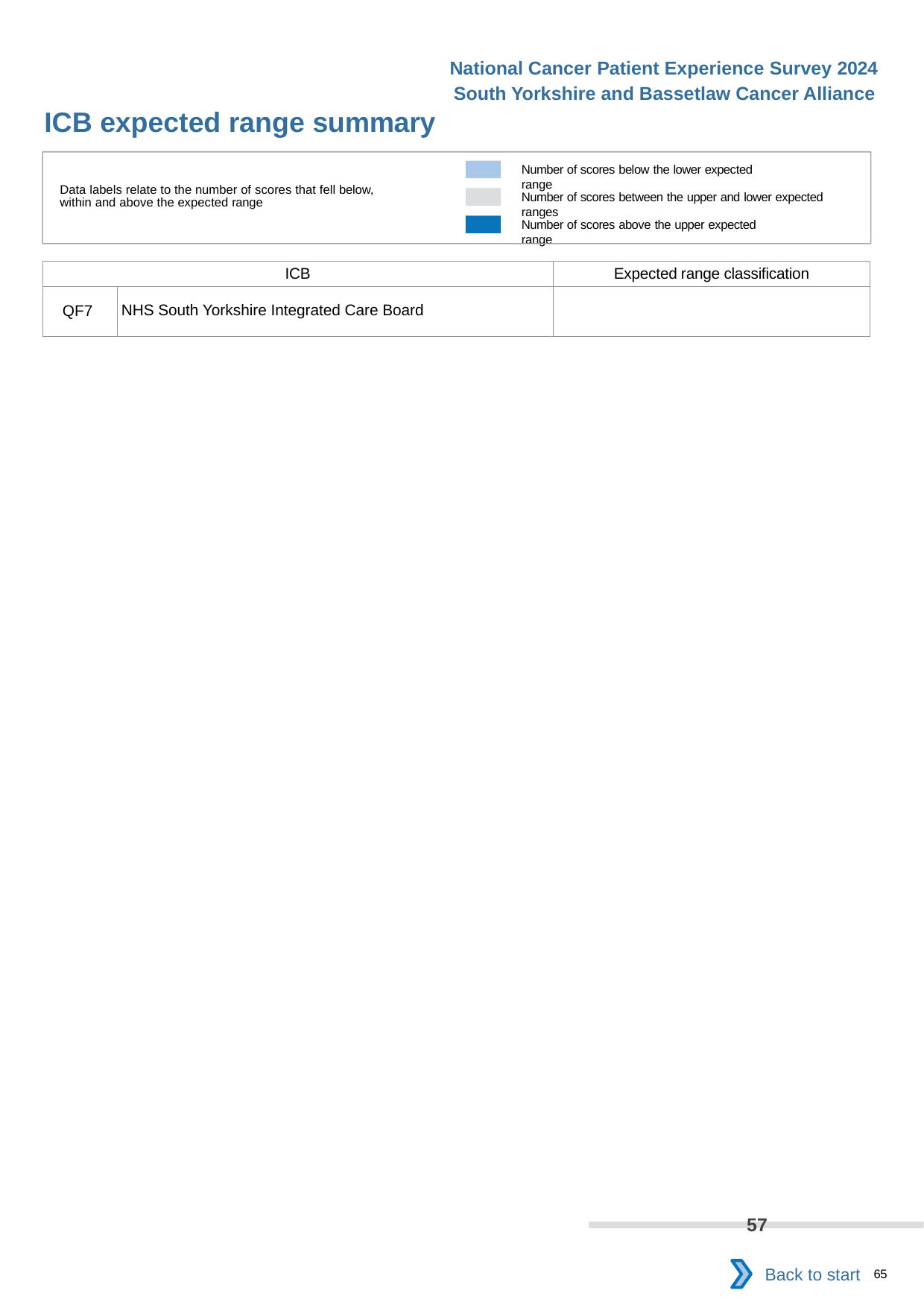
According to the legend, what does the grey colour represent? Number of scores between the upper and lower expected ranges How many entries does the legend in the key box list? 3 According to the legend, what does the dark blue colour represent? Number of scores above the upper expected range What value is printed on the grey bar near the bottom of the slide? 57